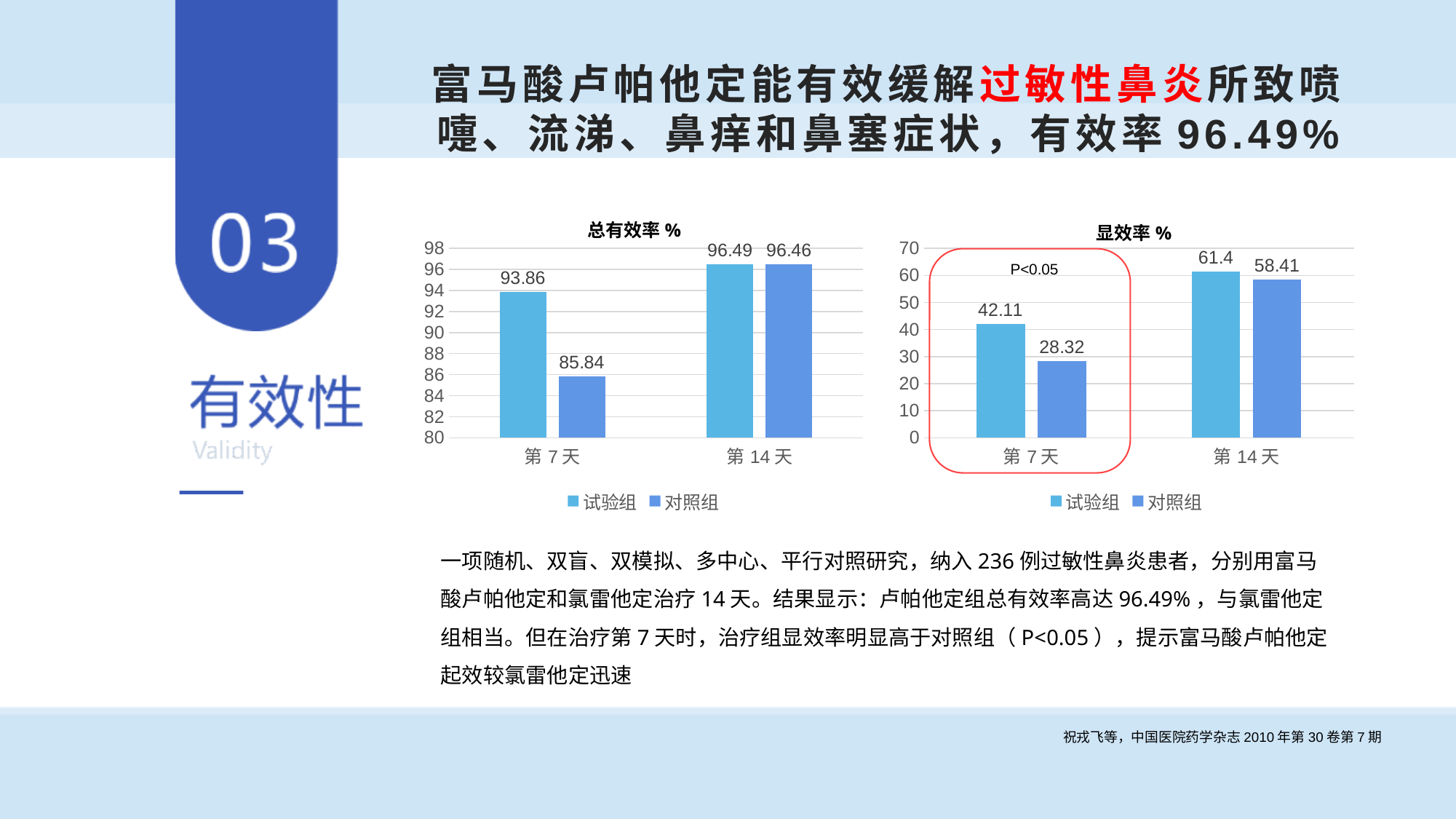
In the 显效率 % chart, does the value for 对照组 rise or fall from 第 7 天 to 第 14 天? rise In the 总有效率 % chart, what is the difference between 试验组 and 对照组 on 第 7 天? 8.02 In the 显效率 % chart, what is the value for 对照组 on 第 7 天? 28.32 In the 显效率 % chart, what is the difference between 试验组 and 对照组 on 第 7 天? 13.79 In the 总有效率 % chart, which is larger on 第 7 天, 试验组 or 对照组? 试验组 What kind of chart is the 总有效率 % chart? bar chart In the 总有效率 % chart, what is the value for 试验组 on 第 7 天? 93.86 In the 显效率 % chart, what is the value for 试验组 on 第 14 天? 61.4 In the 总有效率 % chart, what is the value for 对照组 on 第 14 天? 96.46 How many series does the legend of the 显效率 % chart list? 2 In the 显效率 % chart, which bar is the lowest? 对照组 on 第 7 天 In the 显效率 % chart, is the value for 试验组 on 第 14 天 greater or less than 60? greater